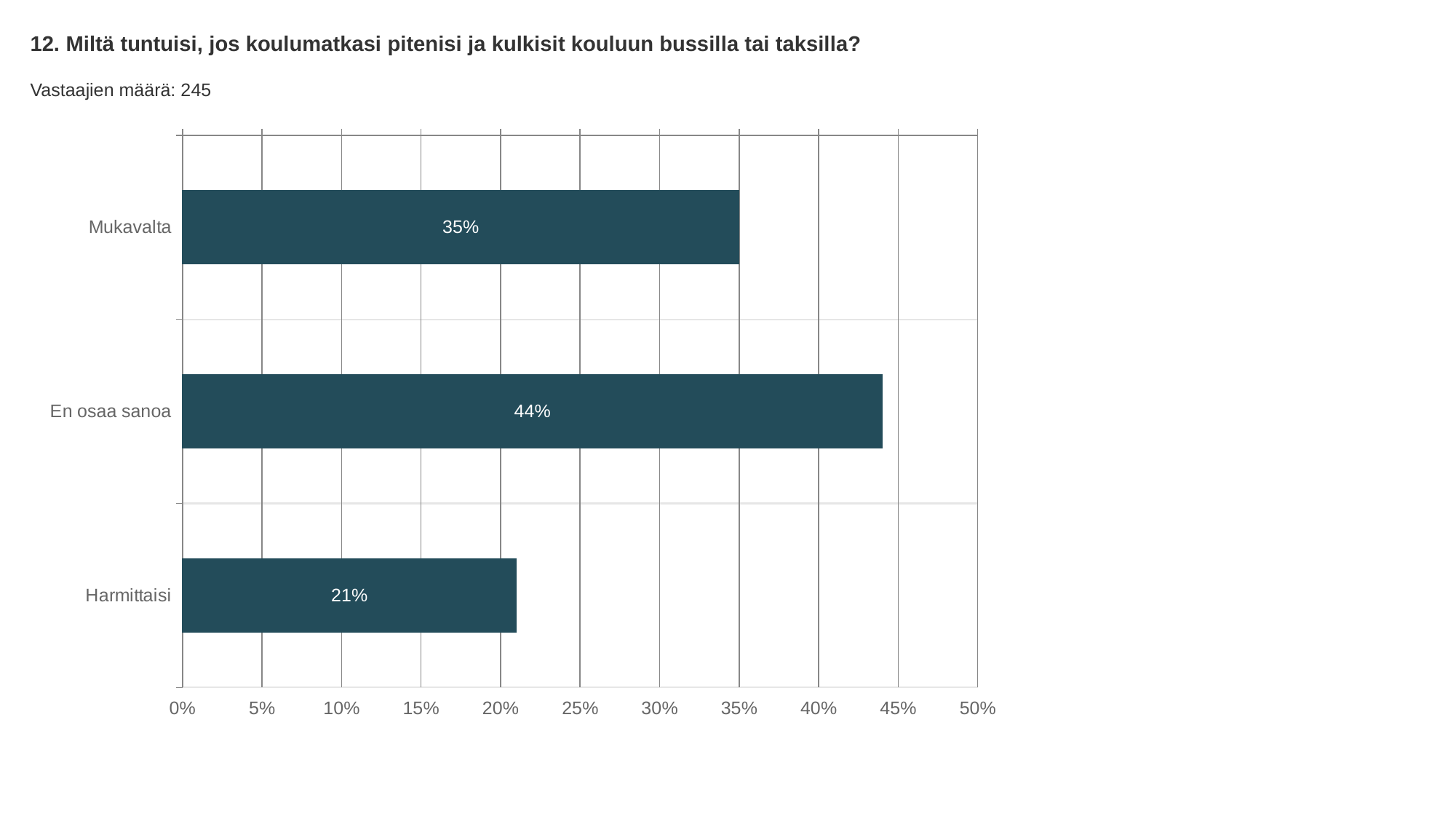
What kind of chart is shown on the slide? bar chart What is the difference between the values for En osaa sanoa and Mukavalta? 9% Which category has the lowest value? Harmittaisi How many respondents (Vastaajien määrä) are reported on the slide? 245 Is the value for En osaa sanoa greater or less than 40%? greater Which category has the highest value? En osaa sanoa How many categories are shown in the chart? 3 What is the value for Mukavalta? 35% Which is larger, the value for Mukavalta or the value for Harmittaisi? Mukavalta What is the value for Harmittaisi? 21% What is the difference between the values for Mukavalta and Harmittaisi? 14% What is the value for En osaa sanoa? 44%